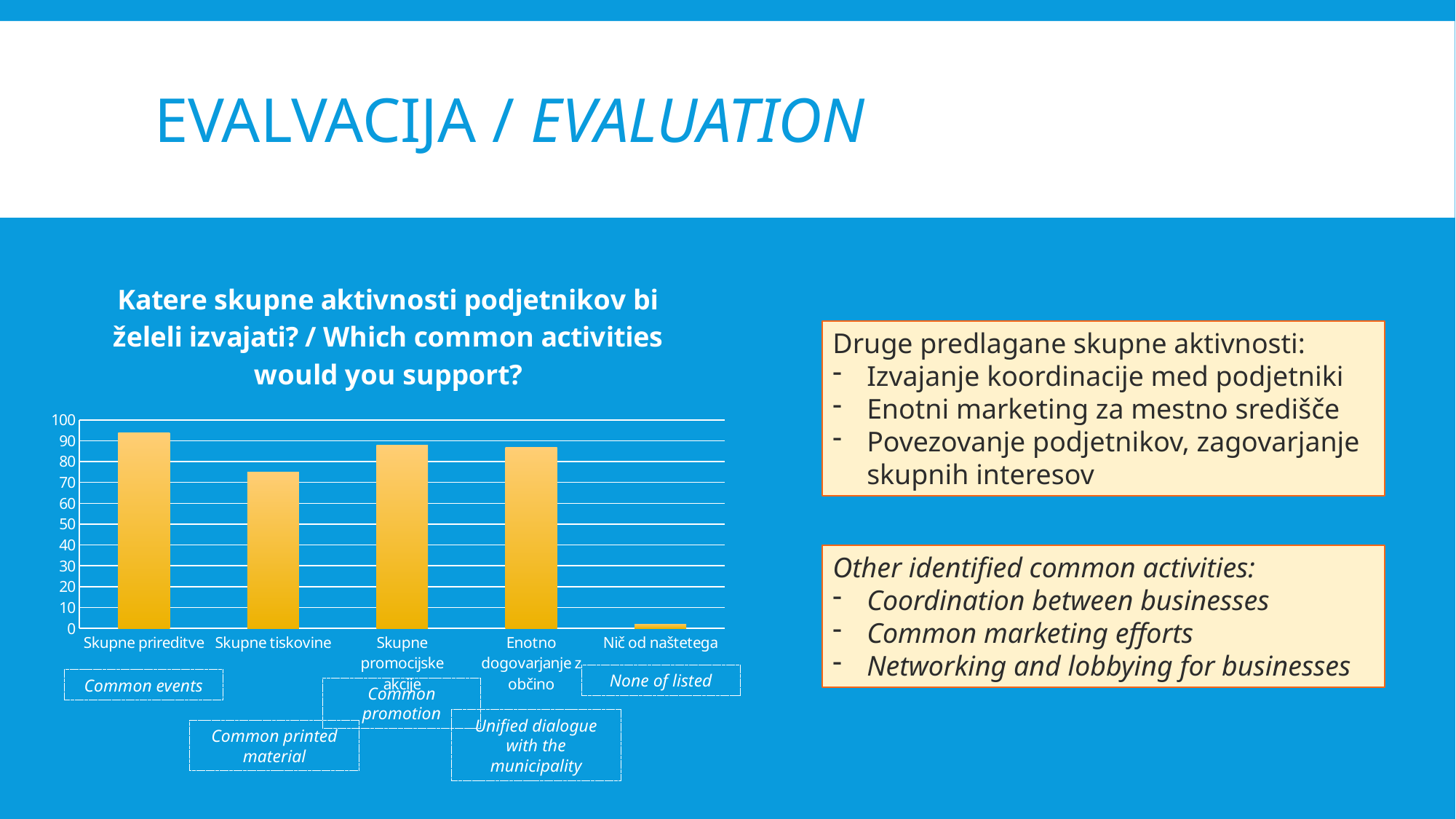
Which category has the highest bar in the chart? Skupne prireditve Is the value for Skupne promocijske akcije greater or less than 80? greater What kind of chart is shown on the slide? bar chart Which category has the lowest bar in the chart? Nič od naštetega How many categories are shown on the x axis of the chart? 5 Which is larger, the value for Skupne tiskovine or the value for Nič od naštetega? Skupne tiskovine Is the value for Nič od naštetega greater or less than 10? less Is the value for Skupne tiskovine greater or less than 80? less What is the English translation label shown under the category Nič od naštetega? None of listed Which is larger, the value for Skupne prireditve or the value for Skupne tiskovine? Skupne prireditve